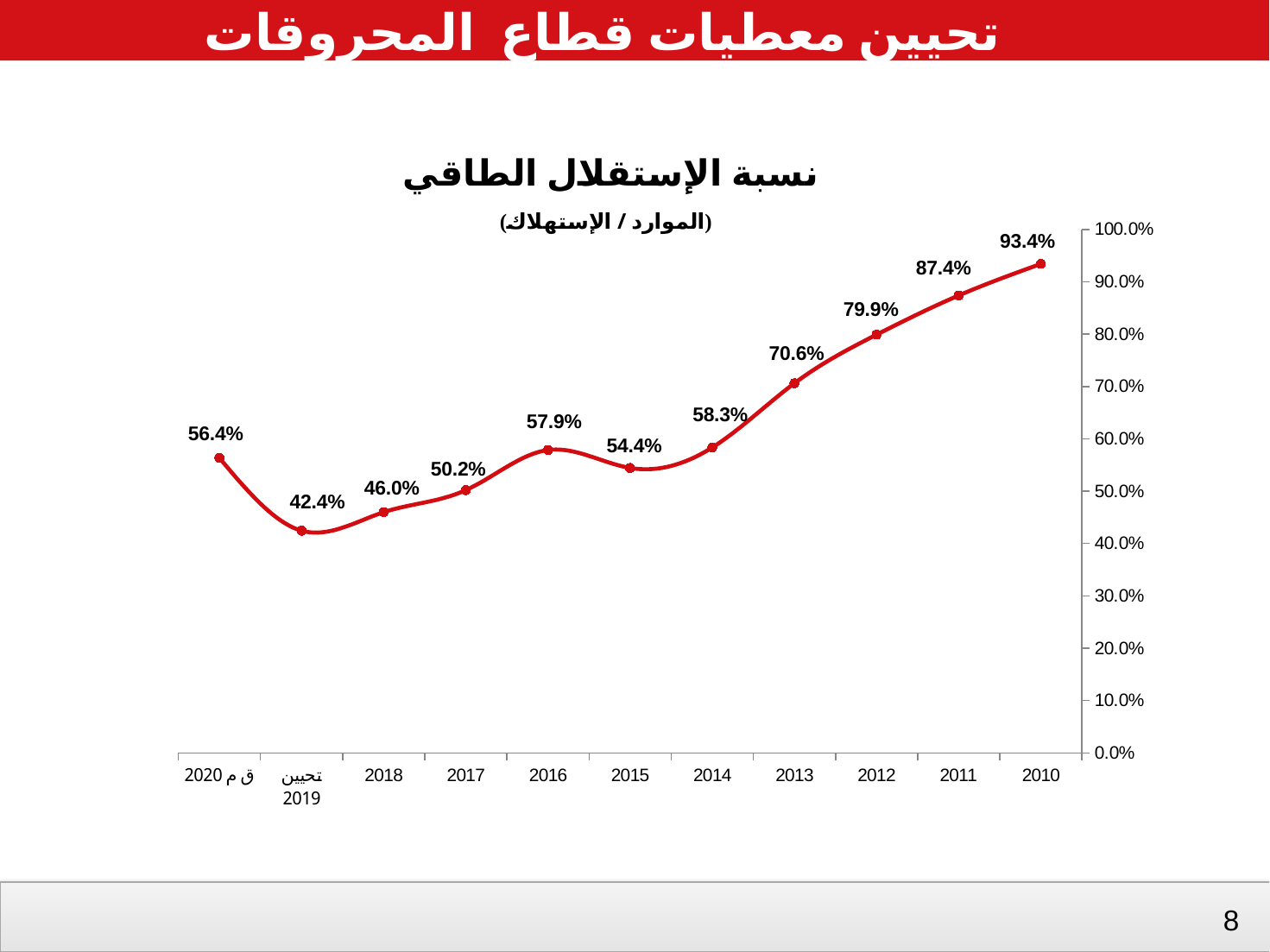
How many data points are plotted on the line? 11 What is the difference between the values for 2011 and 2012? 7.5 percentage points What kind of chart is shown? Line chart What is the value for the category labelled 'ق م 2020'? 56.4% Which category has the lowest value? تحيين 2019 Which year has the highest value? 2010 What is the difference between the highest value (2010) and the lowest value (تحيين 2019)? 51.0 percentage points What is the value for 2018? 46.0% Which is larger, the value for 2016 or the value for 2015? 2016 What is the value for 2010? 93.4% Do the values rise or fall from 2010 to 2014? Fall What is the value for 2013? 70.6%